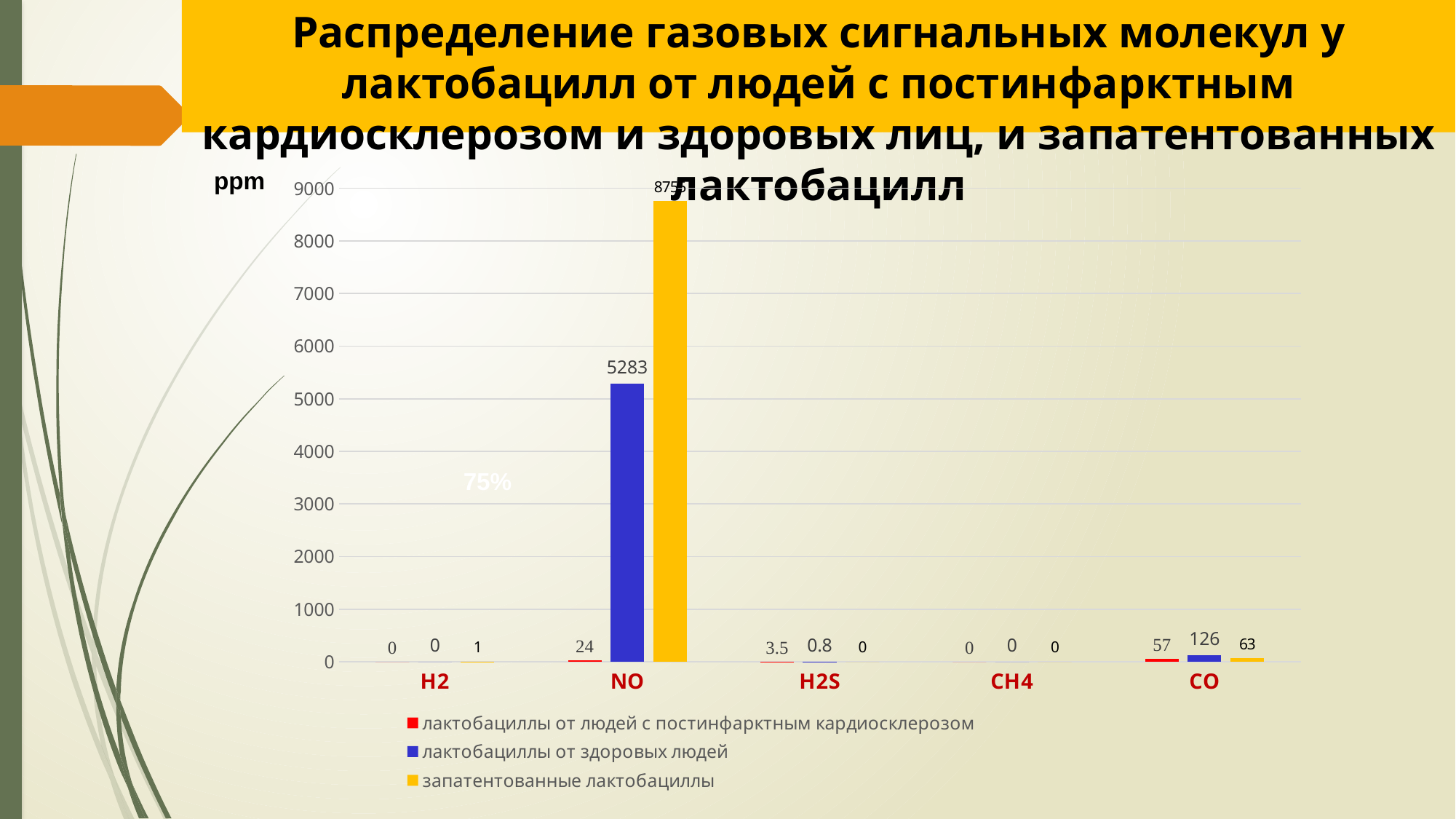
Is the value for NO in the series 'запатентованные лактобациллы' greater or less than 8000? greater What is the value for CO in the series 'лактобациллы от людей с постинфарктным кардиосклерозом'? 57 What is the value for H2 in the series 'запатентованные лактобациллы'? 1 How many categories are shown on the x axis of the chart? 5 What kind of chart is shown on the slide? bar chart Which category has the highest value in the series 'лактобациллы от здоровых людей'? NO How many series does the legend list? 3 What is the value for NO in the series 'лактобациллы от здоровых людей'? 5283 What is the value for CO in the series 'лактобациллы от здоровых людей'? 126 For CO, what is the difference between the value for 'лактобациллы от здоровых людей' and the value for 'запатентованные лактобациллы'? 63 For NO, which series has the larger value: 'лактобациллы от здоровых людей' or 'запатентованные лактобациллы'? запатентованные лактобациллы What is the value for H2S in the series 'лактобациллы от людей с постинфарктным кардиосклерозом'? 3.5